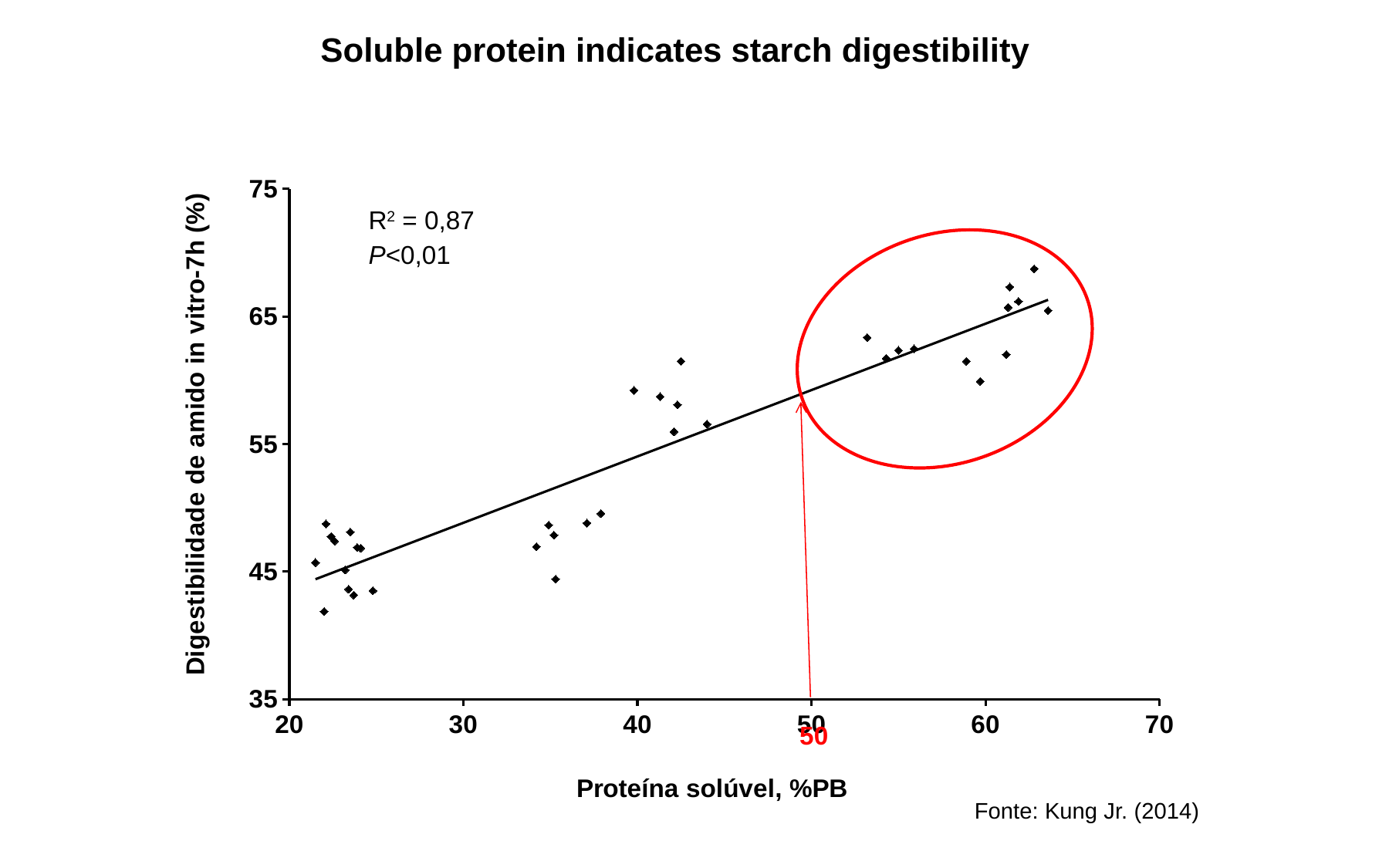
What R² value is printed on the chart? R² = 0,87 Which group of points has lower digestibility: those near 35 %PB soluble protein or those near 42 %PB? those near 35 %PB Is the digestibility of the highest plotted point greater or less than 65? greater What is the title of the chart? Soluble protein indicates starch digestibility Are the points with soluble protein above 60 %PB greater or less than 55 in digestibility? greater Which group of points has higher digestibility: those near 22 %PB soluble protein or those near 62 %PB? those near 62 %PB What kind of chart is shown on the slide? scatter plot Are the points with soluble protein below 25 %PB greater or less than 55 in digestibility? less As soluble protein (Proteína solúvel, %PB) increases along the x axis, does starch digestibility rise or fall? rise